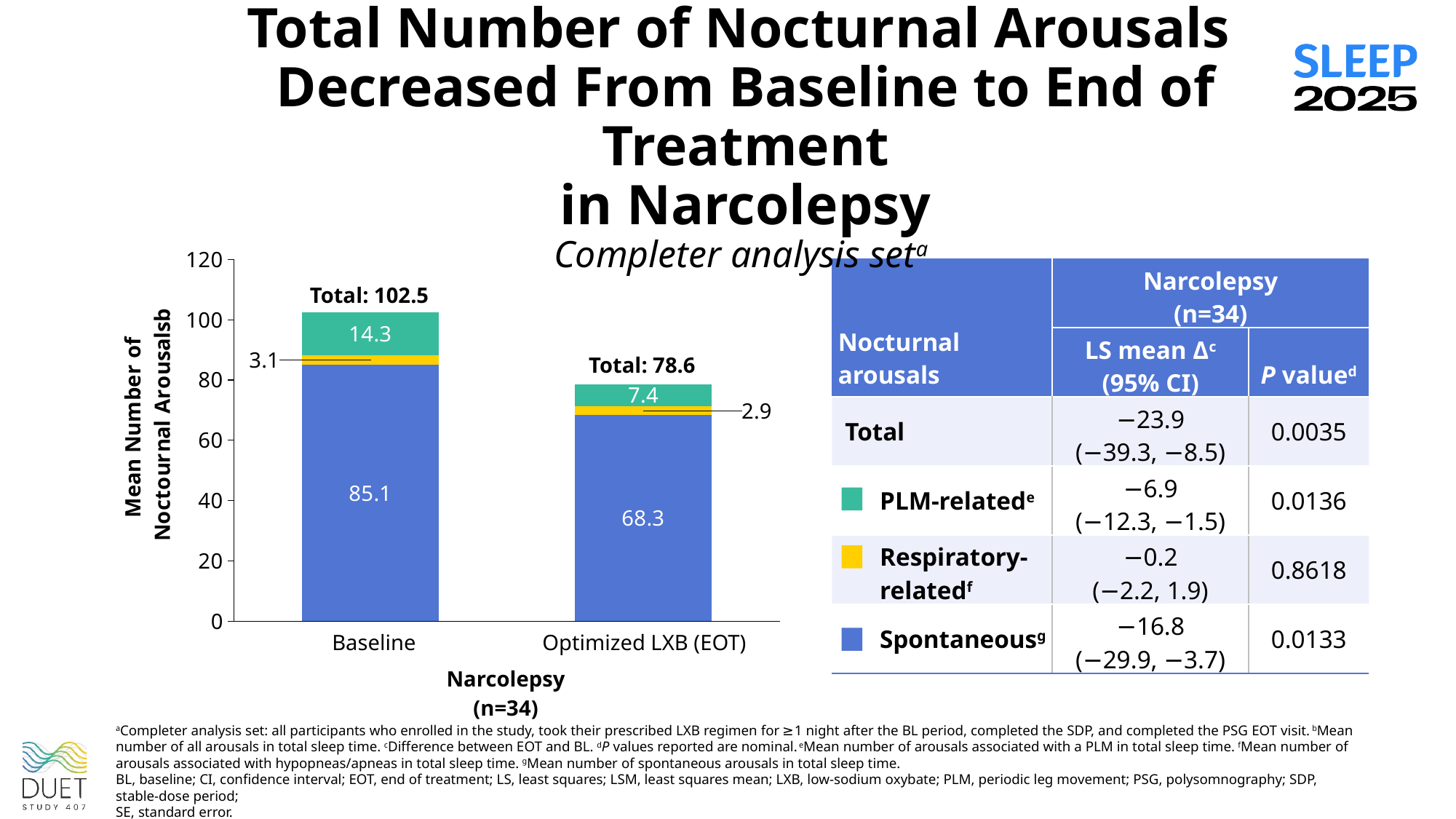
How many bars (categories) are plotted on the x axis of the chart? 2 What is the total number of nocturnal arousals shown for the Optimized LXB (EOT) bar? 78.6 What type of chart is used to show the mean number of nocturnal arousals? Stacked bar chart By how much does the spontaneous (blue) segment differ between Baseline (85.1) and Optimized LXB (EOT) (68.3)? 16.8 What is the value of the PLM-related (green) segment in the Optimized LXB (EOT) bar? 7.4 What is the value of the respiratory-related (yellow) segment in the Optimized LXB (EOT) bar? 2.9 Which bar has the larger PLM-related (green) segment, Baseline or Optimized LXB (EOT)? Baseline What is the difference between the Baseline total (102.5) and the Optimized LXB (EOT) total (78.6)? 23.9 Is the total for the Optimized LXB (EOT) bar greater or less than 80? less What is the total number of nocturnal arousals shown for the Baseline bar? 102.5 What is the value of the respiratory-related (yellow) segment in the Baseline bar? 3.1 What is the value of the spontaneous (blue) segment in the Baseline bar? 85.1